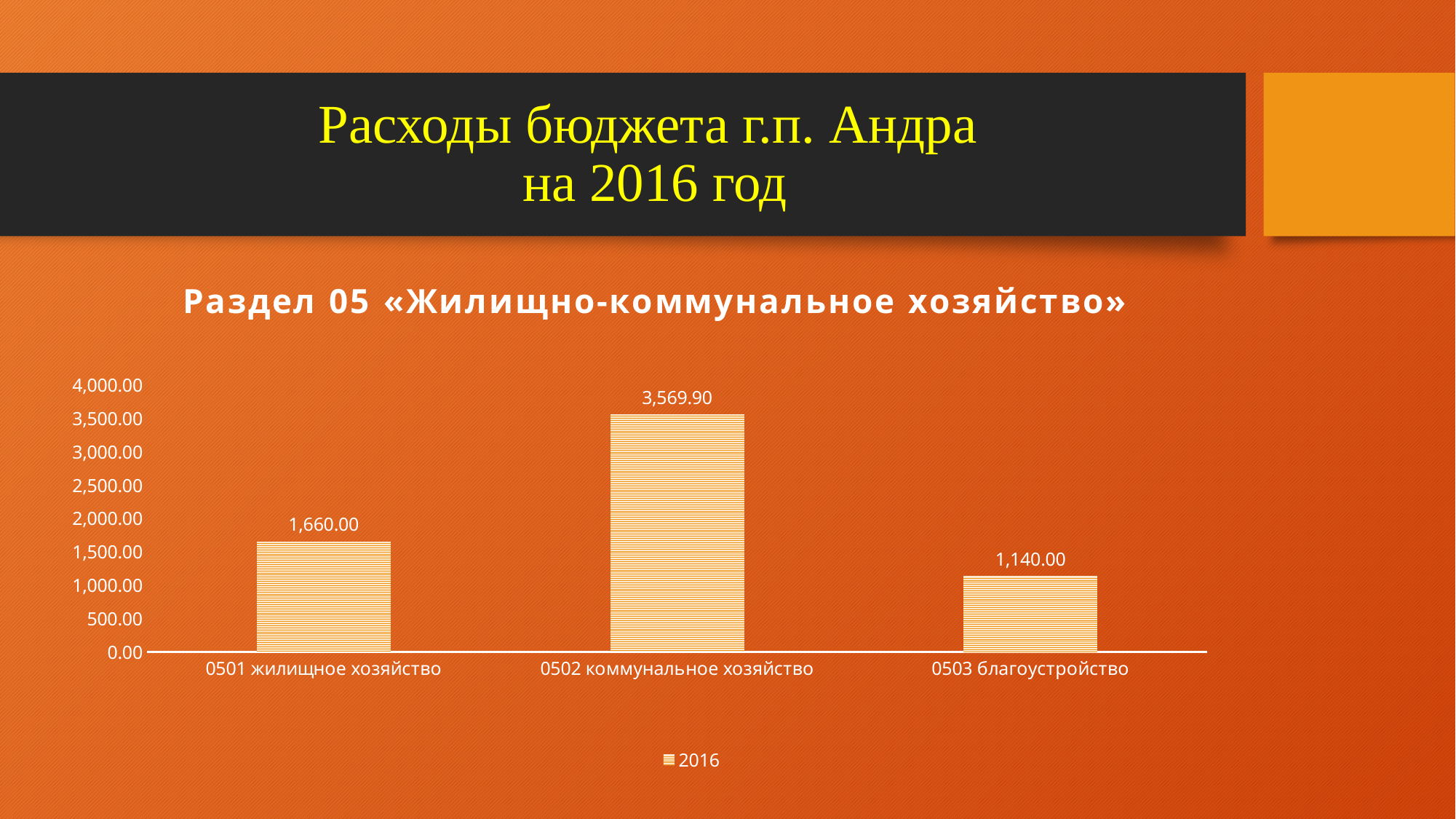
How many series does the legend list? 1 Which category has the highest value? 0502 коммунальное хозяйство What is the difference between the values for 0501 жилищное хозяйство and 0503 благоустройство? 520.00 Which category has the lowest value? 0503 благоустройство What is the value for 0503 благоустройство? 1,140.00 Is the value for 0502 коммунальное хозяйство greater or less than 3,000.00? greater What kind of chart is shown on the slide? bar chart Which is larger, the value for 0501 жилищное хозяйство or the value for 0503 благоустройство? 0501 жилищное хозяйство What is the value for 0501 жилищное хозяйство? 1,660.00 How many categories are shown on the x axis? 3 What is the value for 0502 коммунальное хозяйство? 3,569.90 What is the difference between the values for 0502 коммунальное хозяйство and 0501 жилищное хозяйство? 1,909.90